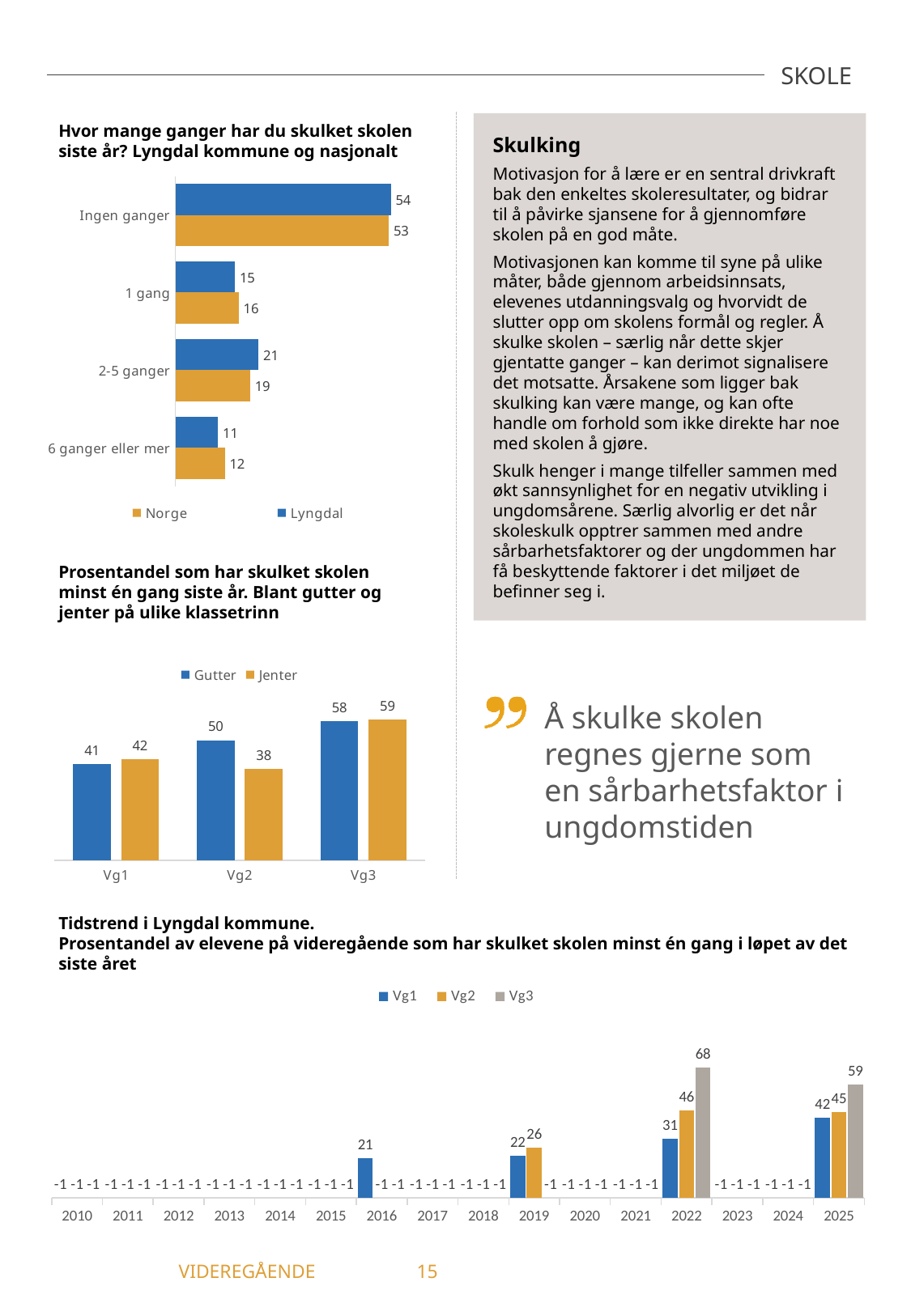
In the chart 'Tidstrend i Lyngdal kommune', how many years are shown on the x axis? 16 In the chart 'Hvor mange ganger har du skulket skolen siste år?', what is the difference between the Lyngdal and Norge values for '2-5 ganger'? 2 In the chart 'Tidstrend i Lyngdal kommune', what is the value for Vg3 in 2022? 68 In the chart 'Hvor mange ganger har du skulket skolen siste år?', what is the value for Norge in the '2-5 ganger' category? 19 In the chart 'Prosentandel som har skulket skolen minst én gang siste år', what is the value for Jenter at Vg2? 38 What type of chart is 'Hvor mange ganger har du skulket skolen siste år?'? Bar chart How many series does the legend list in the chart 'Prosentandel som har skulket skolen minst én gang siste år'? 2 In the chart 'Hvor mange ganger har du skulket skolen siste år?', which category has the lowest value for Lyngdal? 6 ganger eller mer In the chart 'Prosentandel som har skulket skolen minst én gang siste år', is the value for Gutter or Jenter larger at Vg2? Gutter In the chart 'Tidstrend i Lyngdal kommune', what is the difference between the Vg2 values in 2025 and 2019? 19 In the chart 'Hvor mange ganger har du skulket skolen siste år?', what is the value for Lyngdal in the 'Ingen ganger' category? 54 In the chart 'Prosentandel som har skulket skolen minst én gang siste år', which class level has the highest value for Gutter? Vg3